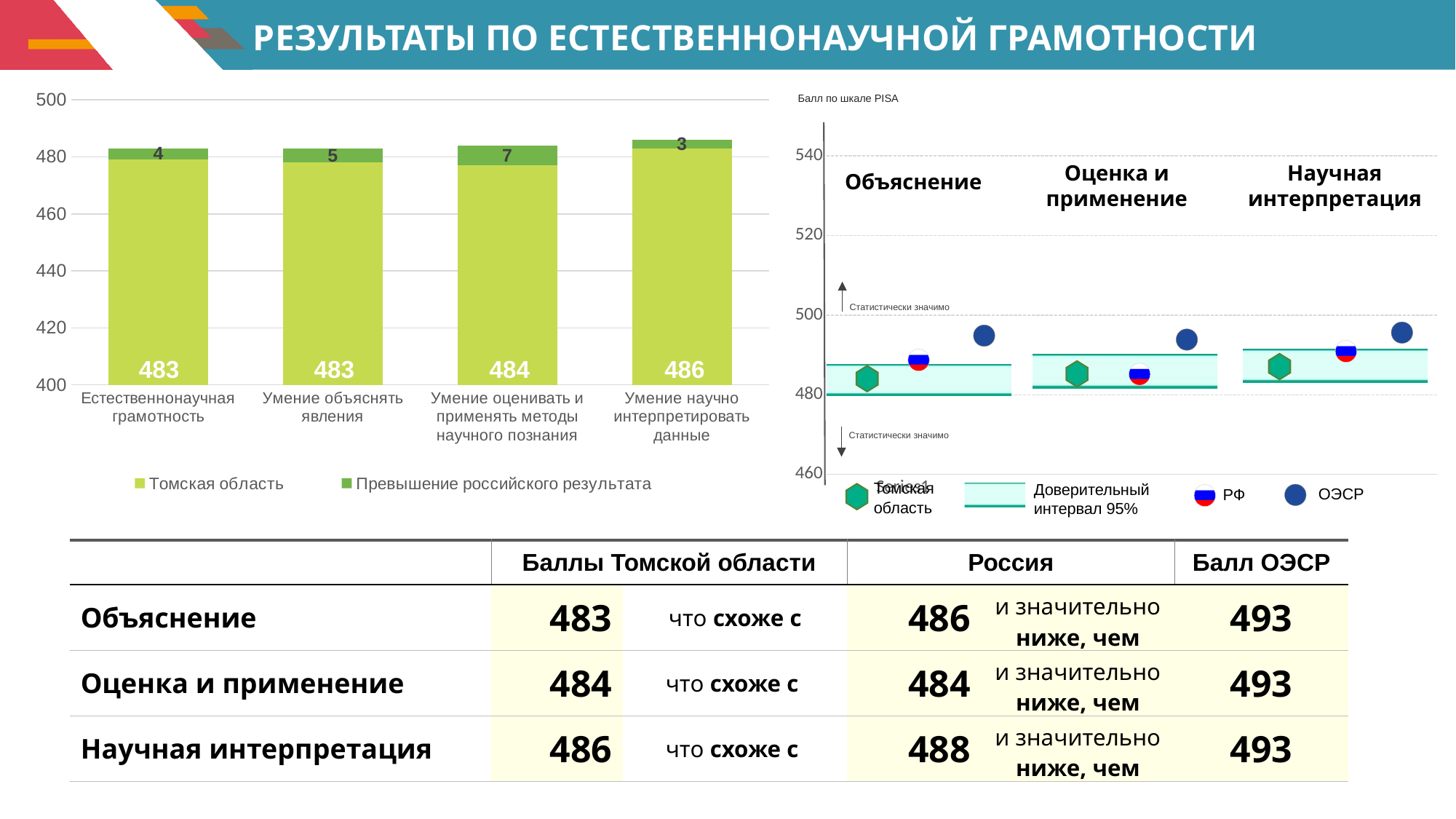
In the right chart (Балл по шкале PISA), is the ОЭСР value for Объяснение greater or less than 480? greater In the left bar chart, what is the difference between the Томская область values for Умение научно интерпретировать данные and Естественнонаучная грамотность? 3 What kind of chart is the left chart on the slide? Bar chart In the left bar chart, which category has the largest Превышение российского результата value? Умение оценивать и применять методы научного познания In the left bar chart, which has the larger Превышение российского результата value: Умение объяснять явления or Естественнонаучная грамотность? Умение объяснять явления In the left bar chart, what is the Томская область value for Умение научно интерпретировать данные? 486 In the left bar chart, what is the Превышение российского результата value for Умение оценивать и применять методы научного познания? 7 In the left bar chart, which category has the smallest Превышение российского результата value? Умение научно интерпретировать данные In the left bar chart, which category has the highest Томская область value? Умение научно интерпретировать данные How many series does the legend of the left bar chart list? 2 How many categories are shown in the left bar chart? 4